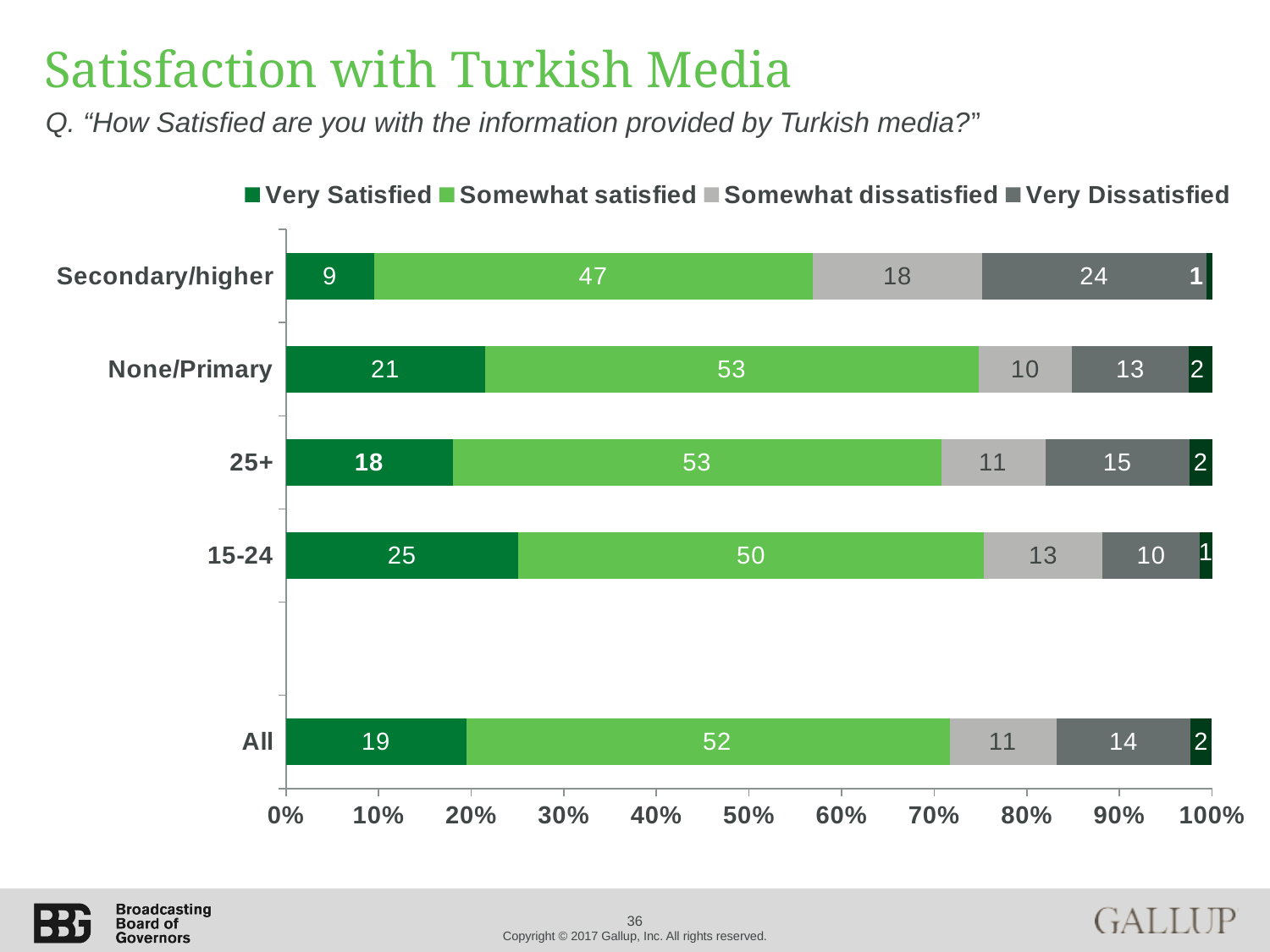
Which is larger: the Somewhat dissatisfied value for Secondary/higher or for None/Primary? Secondary/higher Which group has the highest Very Satisfied value? 15-24 How many groups (categories) are shown on the chart? 5 What is the Somewhat dissatisfied value for the All group? 11 What is the difference between the Very Satisfied values for 15-24 and 25+? 7 How many series does the legend list? 4 What is the Very Dissatisfied value for the 25+ age group? 15 What percentage of respondents with Secondary/higher education are Very Satisfied with the information provided by Turkish media? 9 Which group has the highest Very Dissatisfied value? Secondary/higher Which group has the lowest Very Satisfied value? Secondary/higher What kind of chart is shown on the slide? Stacked bar chart What is the Somewhat satisfied value for the None/Primary group? 53